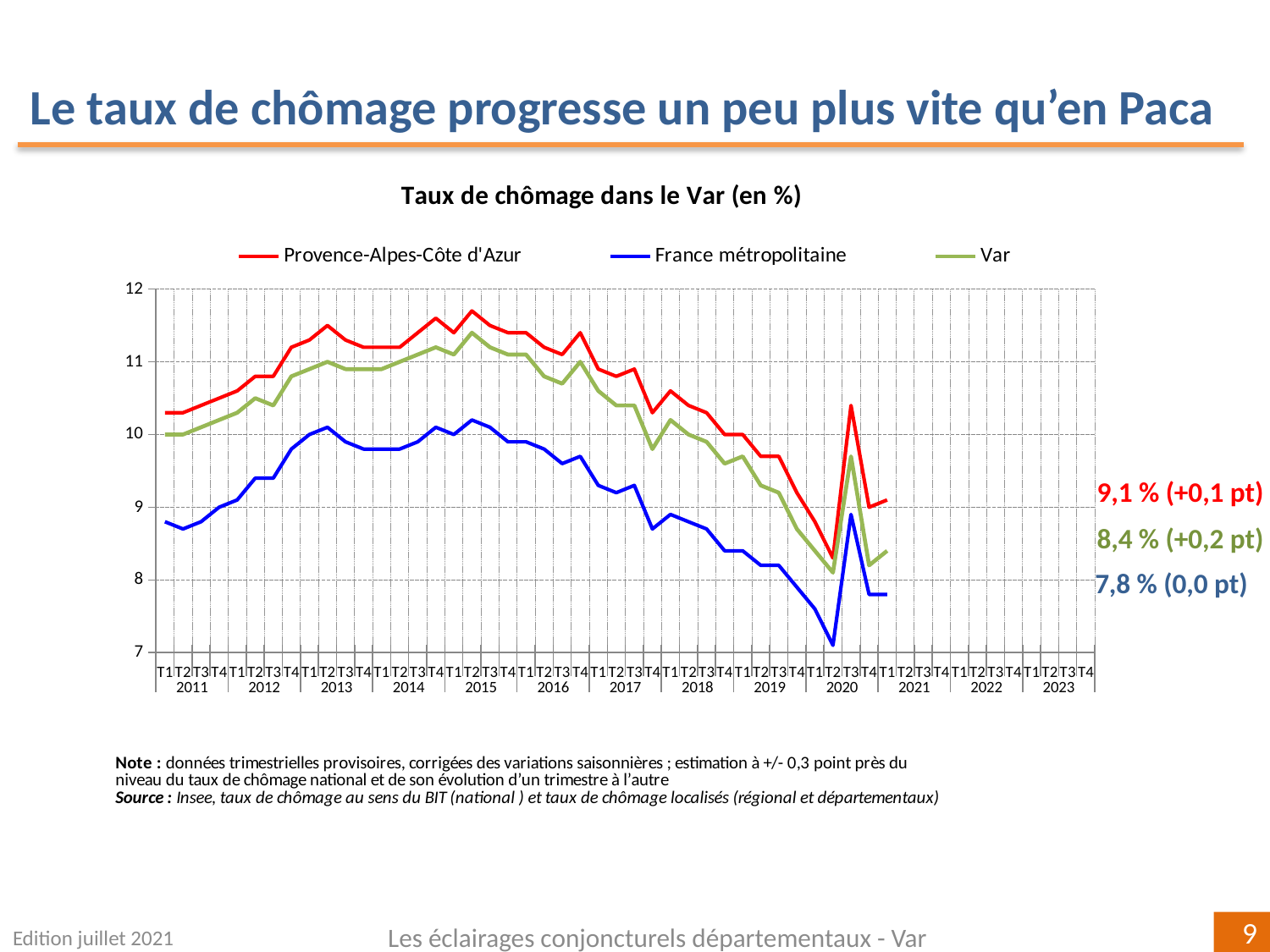
How many series does the legend list? 3 What is the latest unemployment rate shown for Provence-Alpes-Côte d'Azur? 9,1 % What is the title of the chart? Taux de chômage dans le Var (en %) What is the difference between the latest rates for Provence-Alpes-Côte d'Azur (9,1 %) and Var (8,4 %)? 0,7 pt Which series has the highest values across the whole period? Provence-Alpes-Côte d'Azur Between 2015 and 2019, does the Provence-Alpes-Côte d'Azur line rise or fall overall? fall Is the value for France métropolitaine in T2 2020 greater or less than 8? less What is the latest unemployment rate shown for France métropolitaine? 7,8 % Is the value for Var in T3 2020 greater or less than 9? greater Which series has the lowest values across the whole period? France métropolitaine What is the latest unemployment rate shown for Var? 8,4 % What kind of chart is shown on the slide? Line chart